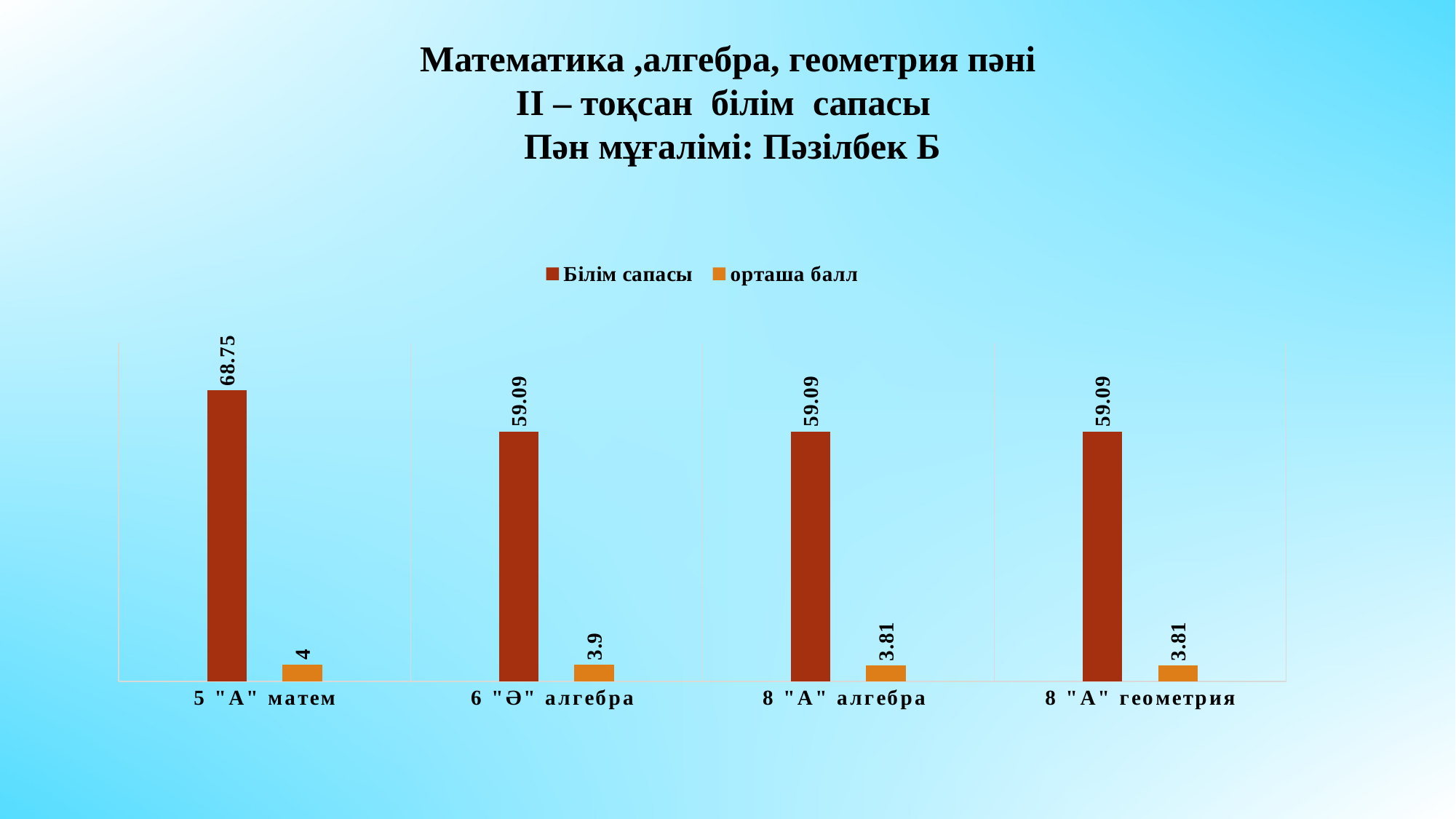
What is the Білім сапасы value for 8 "А" алгебра? 59.09 What is the difference between the Білім сапасы values for 5 "А" матем and 6 "Ә" алгебра? 9.66 How many series does the legend list? 2 Which category has the highest орташа балл value? 5 "А" матем What is the орташа балл value for 6 "Ә" алгебра? 3.9 Which is larger, the орташа балл for 6 "Ә" алгебра or for 8 "А" геометрия? 6 "Ә" алгебра What is the Білім сапасы value for 5 "А" матем? 68.75 What is the орташа балл value for 8 "А" геометрия? 3.81 How many categories are shown on the x axis? 4 What kind of chart is shown on the slide? Bar chart What is the difference between the орташа балл values for 5 "А" матем and 8 "А" алгебра? 0.19 Which category has the highest Білім сапасы value? 5 "А" матем